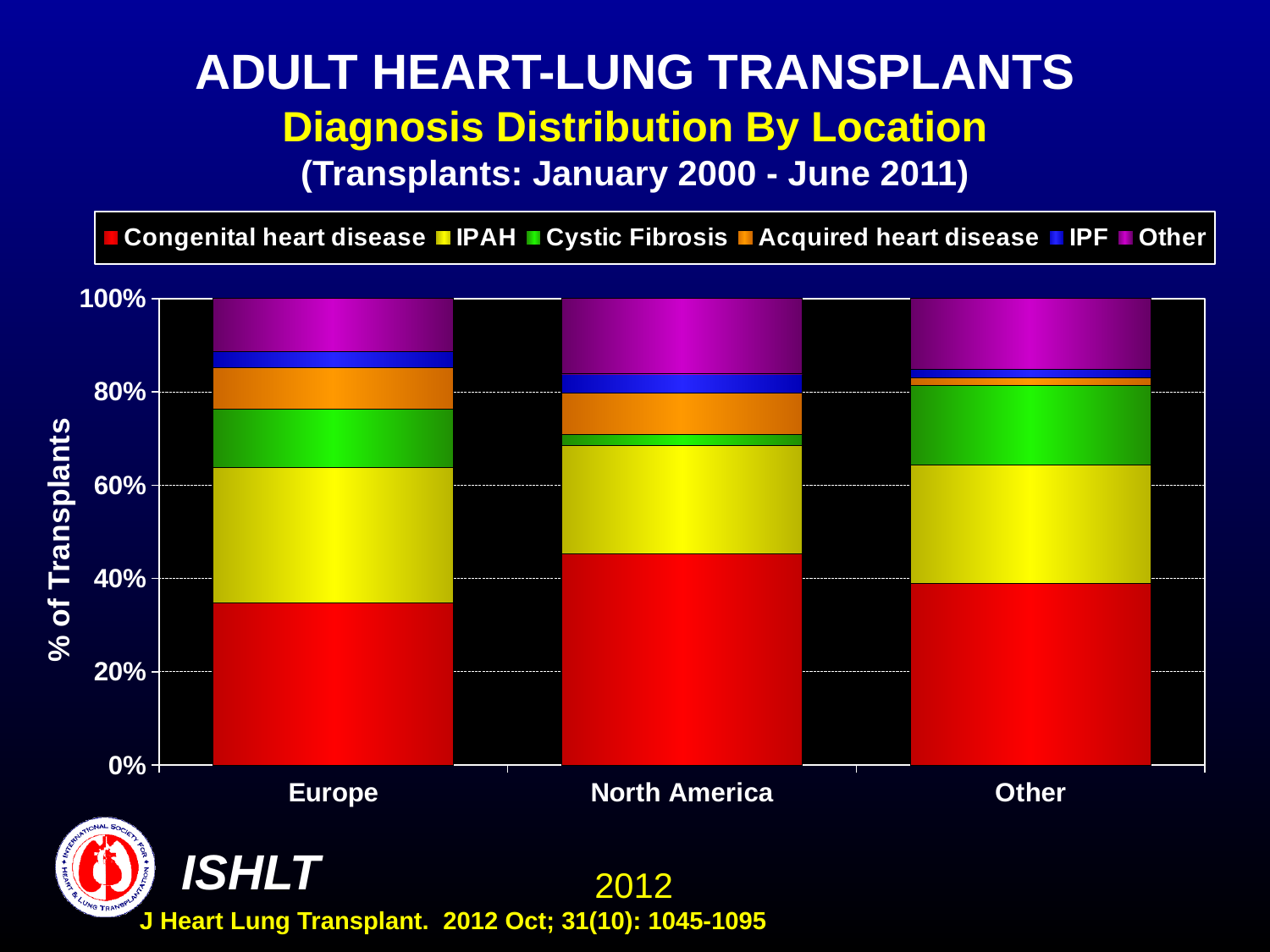
Is the Congenital heart disease share for Europe larger or smaller than that for North America? smaller Is the Cystic Fibrosis share for Other larger or smaller than that for North America? larger Which location has the smallest share of Acquired heart disease? Other What is the label on the y axis? % of Transplants Is the Congenital heart disease share for North America greater or less than 40%? greater Is the Congenital heart disease share for Europe greater or less than 40%? less How many location categories are shown on the x axis? 3 How many diagnosis series does the legend list? 6 Which colour represents IPAH in the legend? Yellow Which location has the smallest share of Cystic Fibrosis? North America What kind of chart is shown on the slide? Stacked bar chart Which location has the largest share of Congenital heart disease? North America